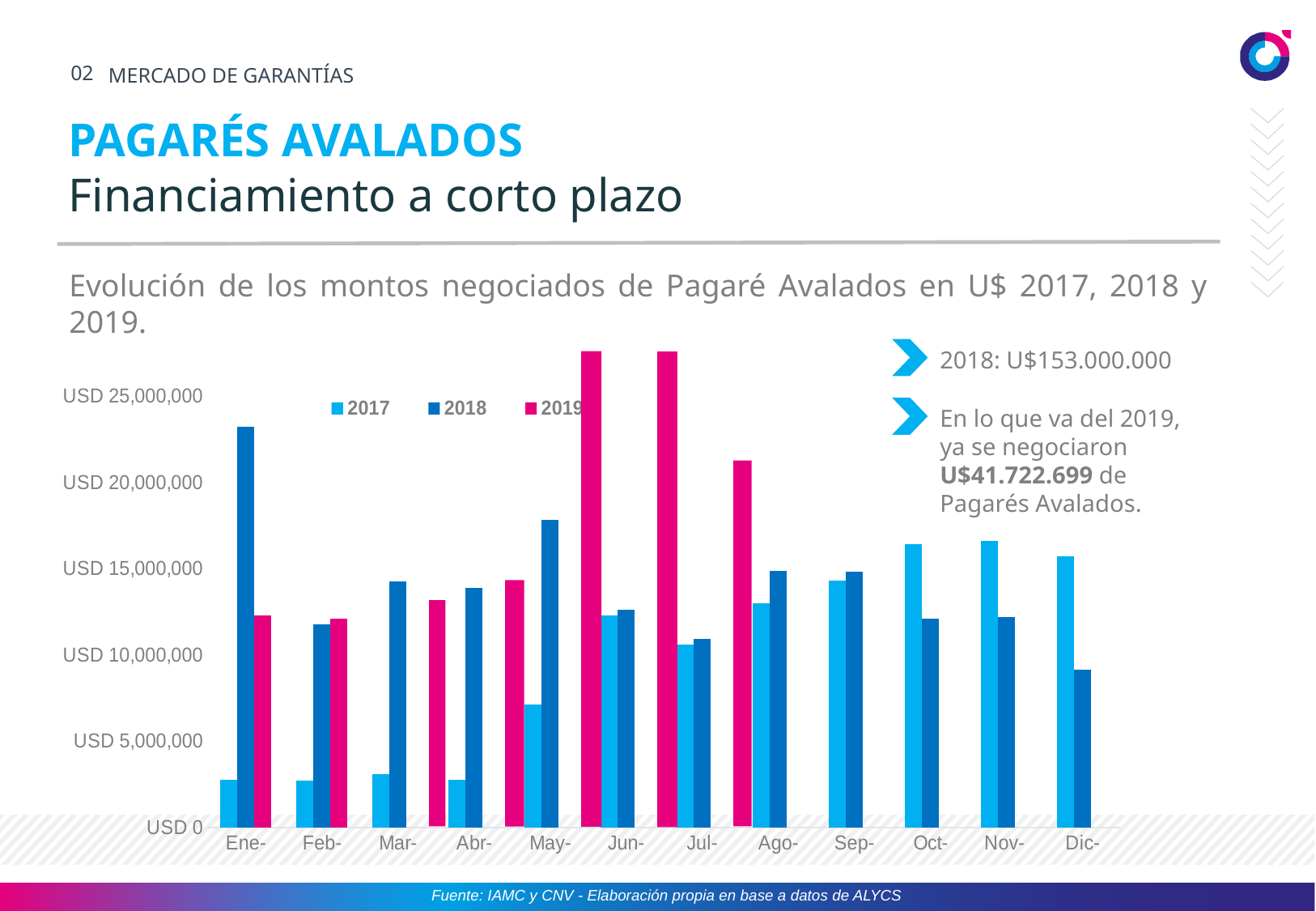
What kind of chart is shown on the slide? bar chart Is the 2019 value for Jun- greater or less than USD 25,000,000? greater Is the 2017 value for Ene- greater or less than USD 5,000,000? less Which month has the highest 2018 value? Ene- In Ago-, which series has the larger value, 2017 or 2019? 2019 For how many months does the chart show a 2019 bar? 7 Is the 2018 value for Ene- greater or less than USD 20,000,000? greater How many months are shown on the x axis of the chart? 12 How many series does the chart legend list? 3 Which month has the lowest 2018 value? Dic- Do the 2017 values generally rise or fall from Ene- to Dic-? rise